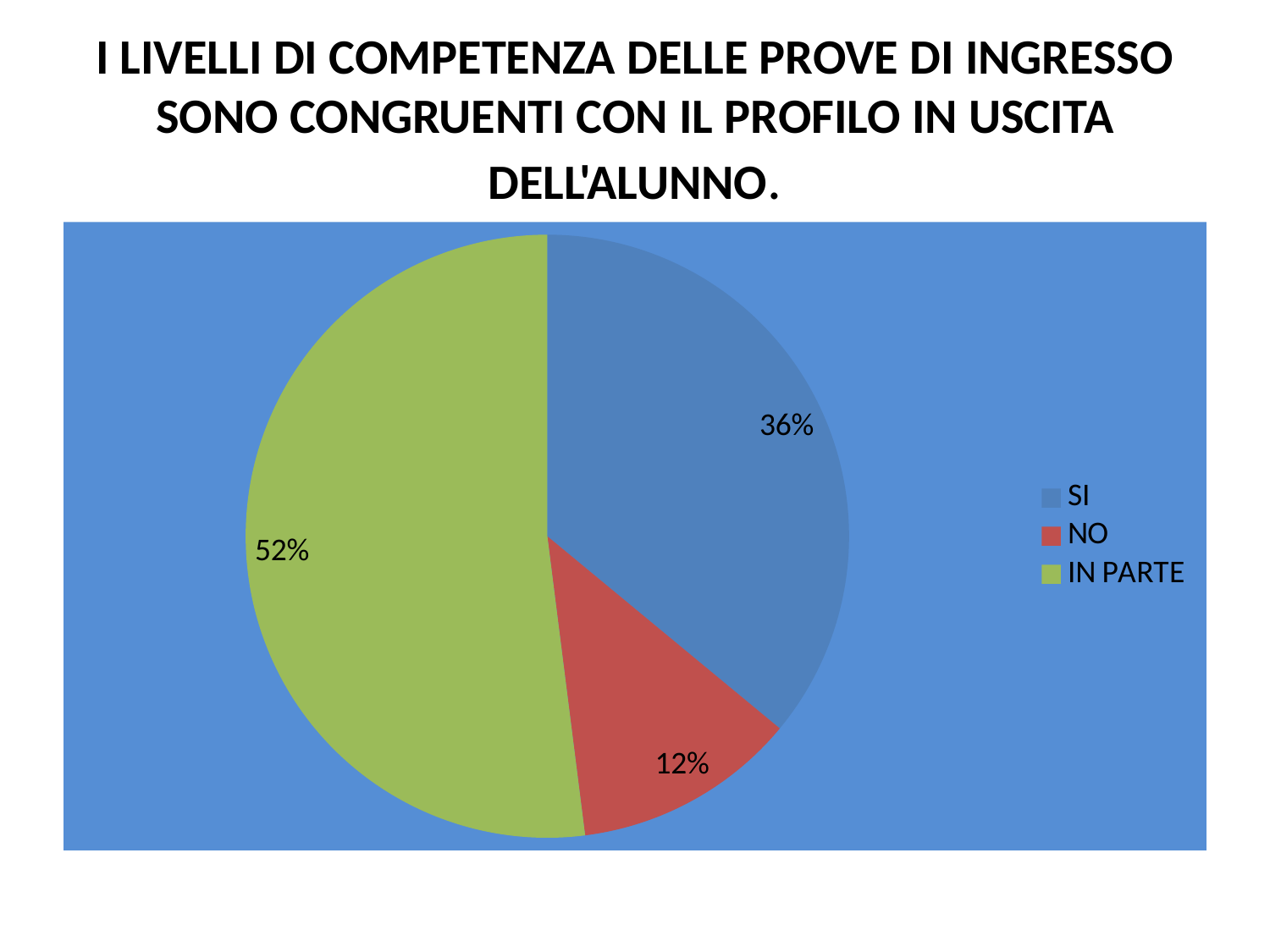
What share of the pie does the IN PARTE slice represent? 52% What is the difference in percentage points between the IN PARTE slice and the SI slice? 16% What is the value shown for the SI slice? 36% What is the difference in percentage points between the SI slice and the NO slice? 24% Which category has the largest slice of the pie? IN PARTE How many categories does the pie chart show? 3 What kind of chart is shown on the slide? Pie chart What are the three legend entries of the chart? SI, NO, IN PARTE Which category has the smallest slice of the pie? NO What colour is the IN PARTE slice in the pie chart? Green What is the value shown for the NO slice? 12% Which is larger, the SI slice or the NO slice? SI